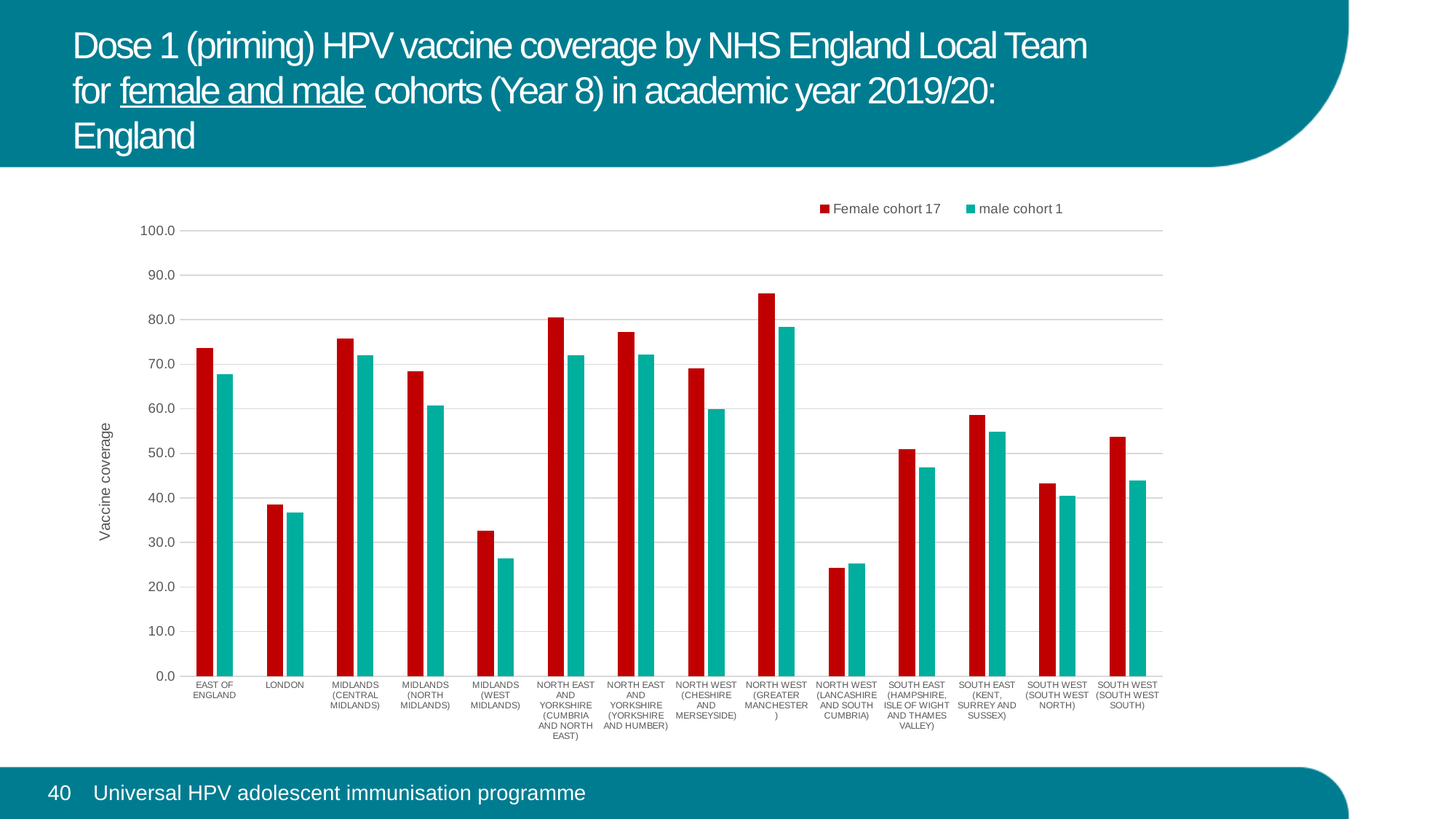
How many NHS England Local Teams are shown on the x axis? 14 Which local team has the lowest Female cohort 17 coverage? NORTH WEST (LANCASHIRE AND SOUTH CUMBRIA) Is the Female cohort 17 value for EAST OF ENGLAND greater or less than 70.0? greater Which local team has the highest male cohort 1 coverage? NORTH WEST (GREATER MANCHESTER) Is the male cohort 1 value for MIDLANDS (WEST MIDLANDS) greater or less than 30.0? less Is the male cohort 1 value for SOUTH EAST (KENT, SURREY AND SUSSEX) greater or less than 50.0? greater What kind of chart is shown on the slide? bar chart For MIDLANDS (WEST MIDLANDS), which is larger: the Female cohort 17 value or the male cohort 1 value? Female cohort 17 How many series does the legend list? 2 Which local team has the highest Female cohort 17 coverage? NORTH WEST (GREATER MANCHESTER) What is the label of the vertical axis? Vaccine coverage